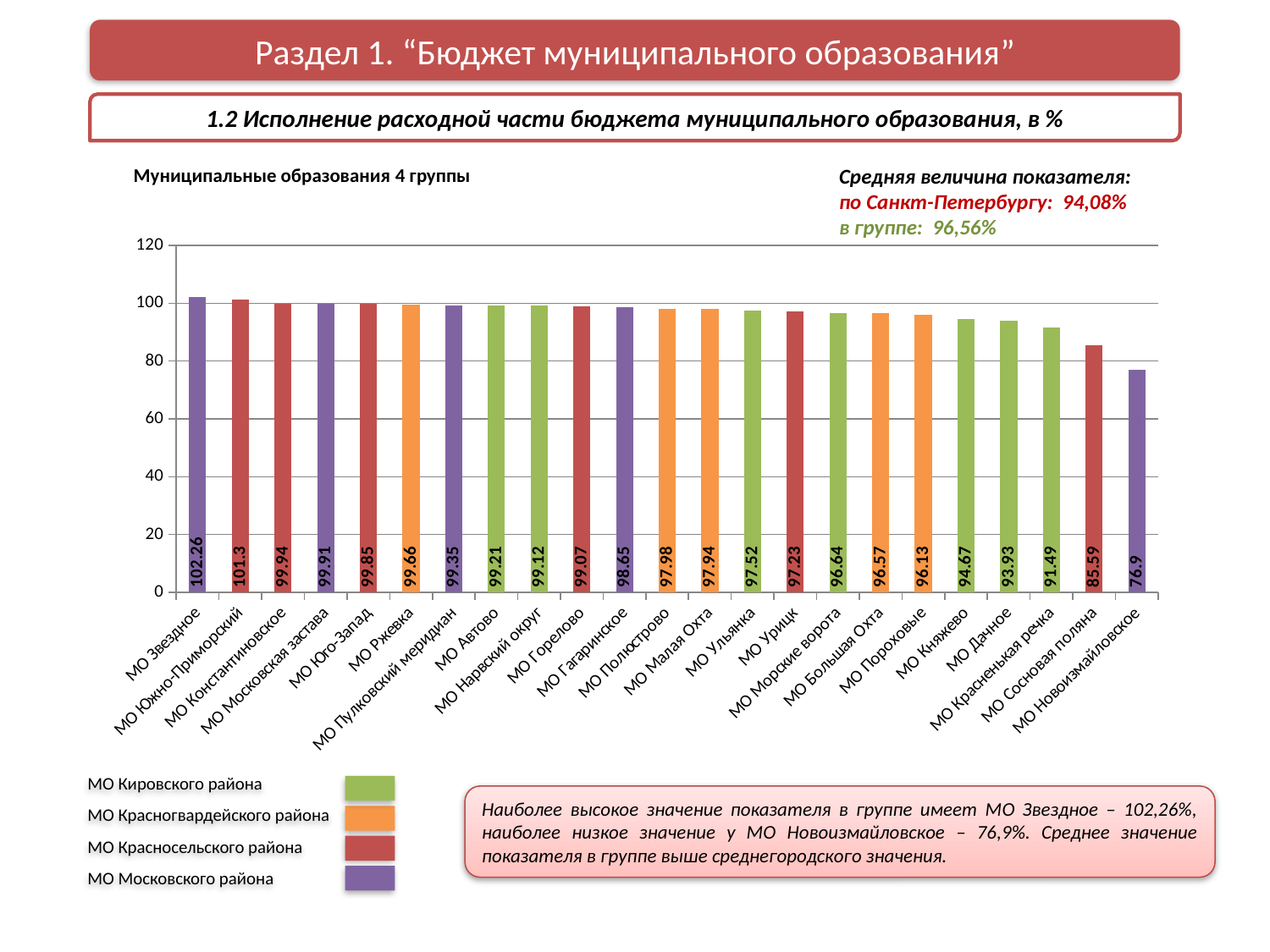
Which is larger, the value for МО Дачное or the value for МО Красненькая речка? МО Дачное Is the value for МО Новоизмайловское greater or less than 80? less Which municipality has the highest value on the chart? МО Звездное What value is shown for МО Новоизмайловское? 76.9 Which municipality has the lowest value on the chart? МО Новоизмайловское What is the difference between the values for МО Звездное and МО Новоизмайловское? 25.36 What value is shown for МО Звездное? 102.26 What kind of chart is shown on the slide? bar chart What value is shown for МО Сосновая поляна? 85.59 How many entries does the legend list? 4 How many municipalities are shown on the chart? 23 What value is shown for МО Ульянка? 97.52